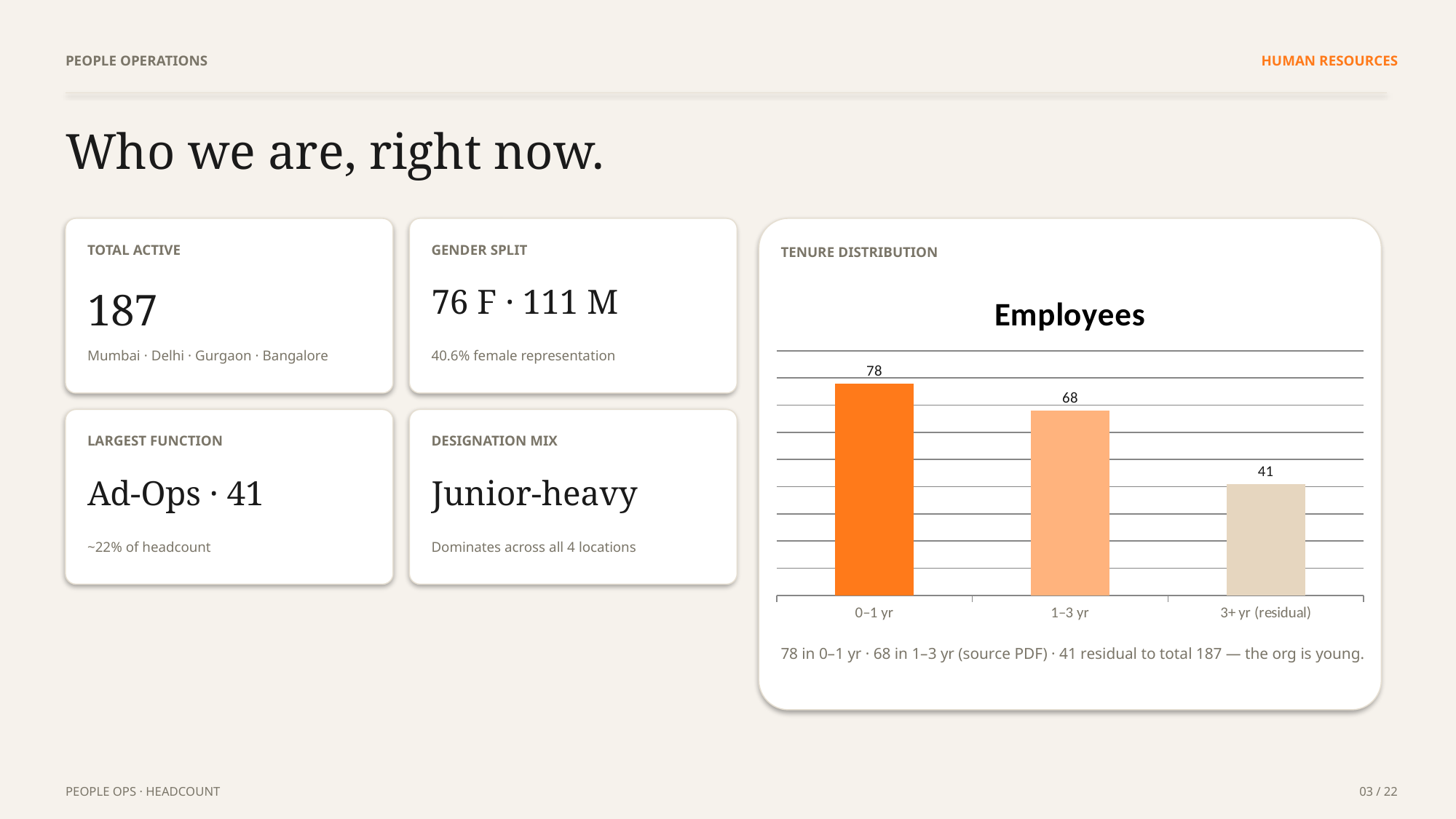
What is the difference between the 1–3 yr and 3+ yr (residual) values in the Employees chart? 27 What kind of chart is the Employees chart? bar chart What is the title of the chart in the Tenure Distribution panel? Employees Which tenure category has the highest number of employees? 0–1 yr Which is larger in the Employees chart: 1–3 yr or 3+ yr (residual)? 1–3 yr What is the value for the 1–3 yr category in the Employees chart? 68 Which tenure category has the lowest number of employees? 3+ yr (residual) What is the value for the 0–1 yr category in the Employees chart? 78 What is the difference between the 0–1 yr and 1–3 yr values in the Employees chart? 10 Do the values in the Employees chart rise or fall from left to right along the x axis? fall How many tenure categories are shown in the Employees chart? 3 What is the value for the 3+ yr (residual) category in the Employees chart? 41